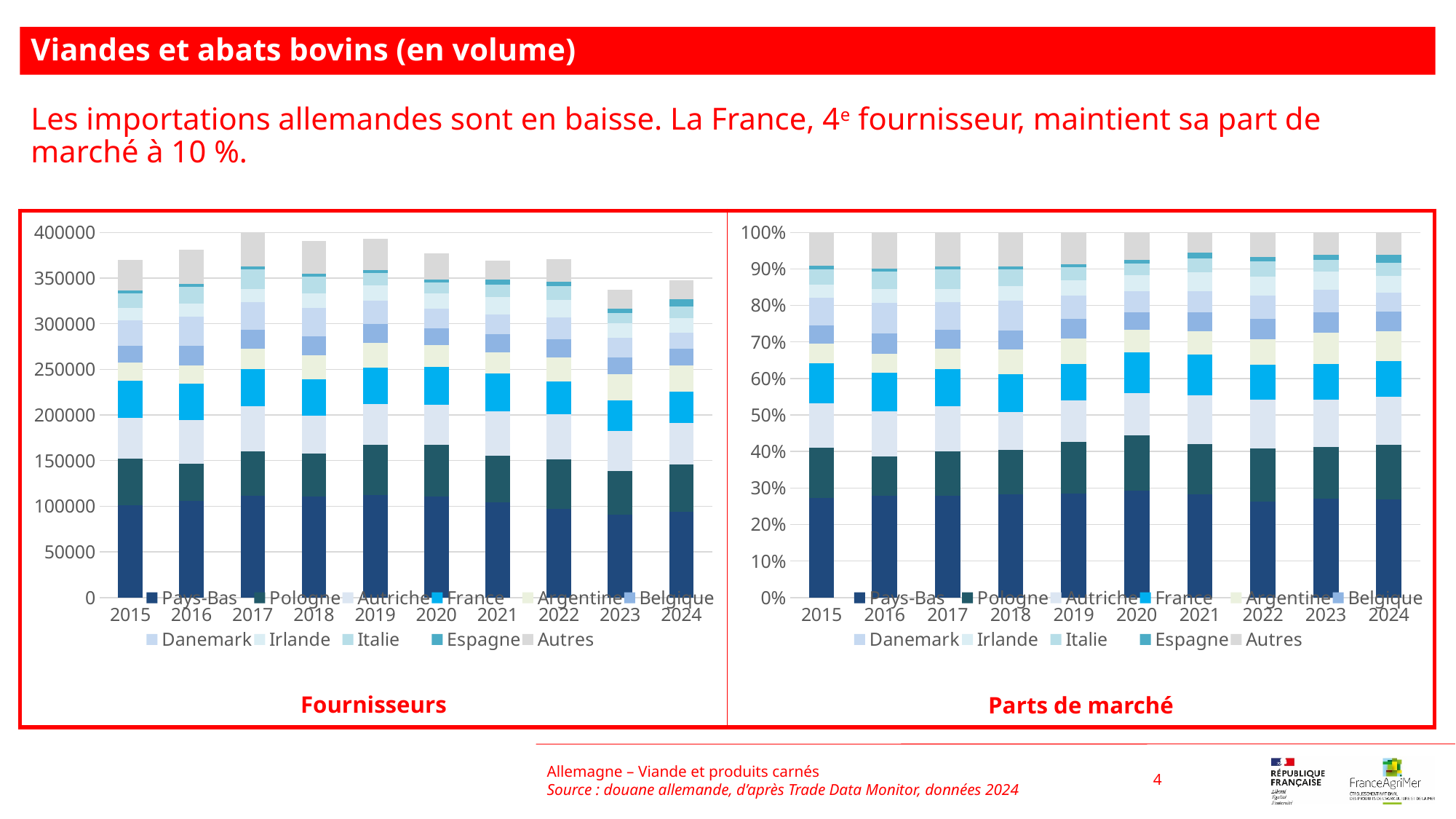
What kind of chart is the 'Parts de marché' chart on the right? stacked bar chart In the 'Fournisseurs' chart, is the total height of the 2017 bar greater or less than 350000? greater In the 'Parts de marché' chart, how many series does the legend list? 11 In the 'Fournisseurs' chart, how many years are shown on the x axis? 10 In the 'Fournisseurs' chart, is the total height of the 2015 bar greater or less than 400000? less In the 'Parts de marché' chart, which series is listed last in the legend? Autres In the 'Fournisseurs' chart, is the total height of the 2023 bar greater or less than 350000? less What kind of chart is the 'Fournisseurs' chart on the left? stacked bar chart In the 'Fournisseurs' chart, which series is listed first in the legend? Pays-Bas